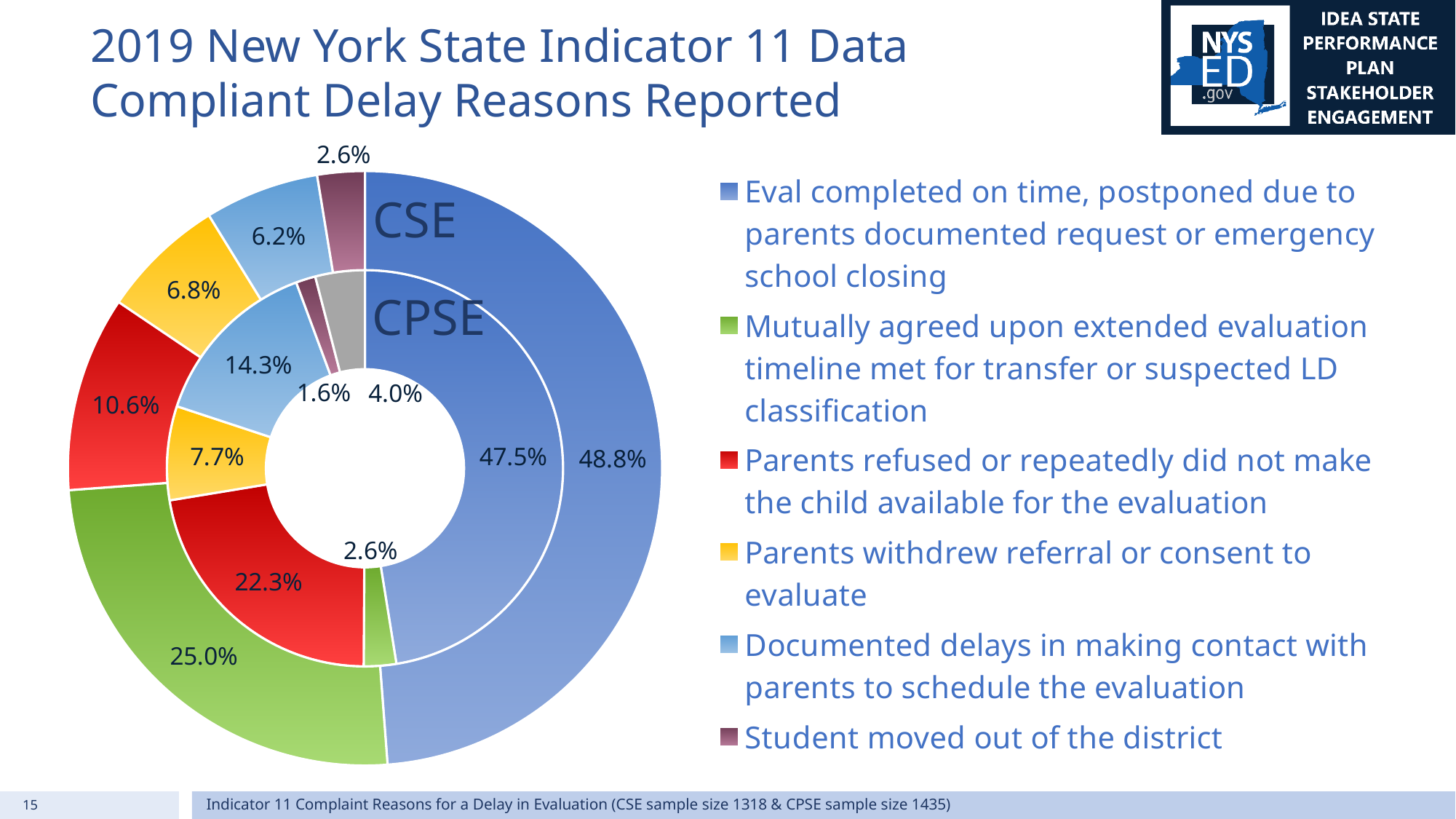
Which legend reason has the smallest share in the CPSE ring? Student moved out of the district What kind of chart is shown on the slide? Doughnut chart Which ring of the doughnut chart represents CPSE, the inner or the outer? Inner Which is larger: the CSE share or the CPSE share for 'Mutually agreed upon extended evaluation timeline met for transfer or suspected LD classification'? CSE In the CSE ring, what percentage is shown for 'Eval completed on time, postponed due to parents documented request or emergency school closing'? 48.8% How many entries does the legend list? 6 In the CPSE ring, what percentage is shown for 'Documented delays in making contact with parents to schedule the evaluation'? 14.3% In the CPSE ring, what percentage is shown for 'Parents refused or repeatedly did not make the child available for the evaluation'? 22.3% Which reason has the largest share in the CSE ring? Eval completed on time, postponed due to parents documented request or emergency school closing In the CSE ring, what percentage is shown for 'Mutually agreed upon extended evaluation timeline met for transfer or suspected LD classification'? 25.0% What is the difference between the CSE and CPSE percentages for 'Parents refused or repeatedly did not make the child available for the evaluation'? 11.7% In the CPSE ring, what percentage is shown for 'Student moved out of the district'? 1.6%